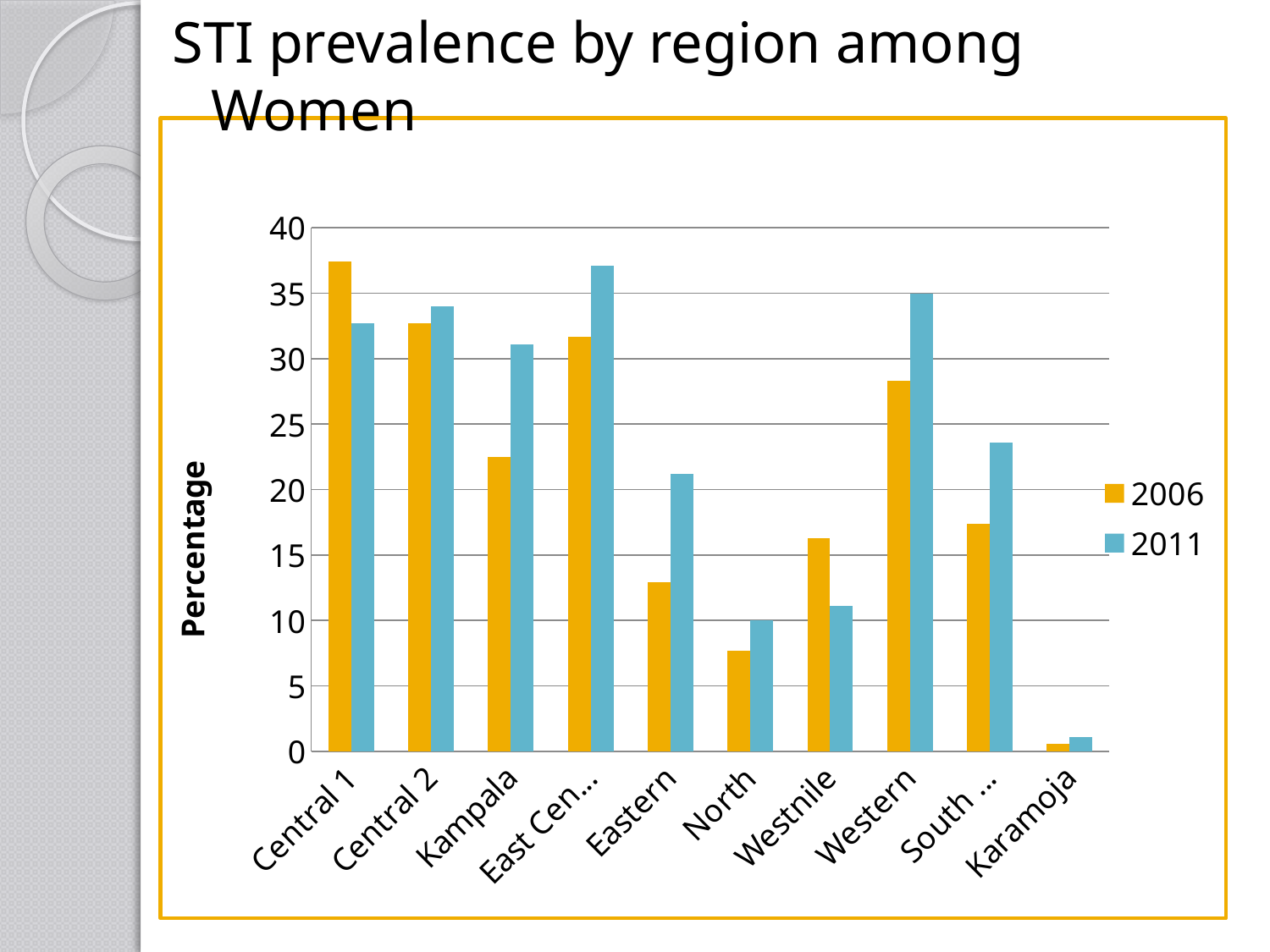
Is the 2011 value for Western greater or less than 30? greater What kind of chart is shown on the slide? bar chart For Westnile, which year has the larger value, 2006 or 2011? 2006 Which region has the lowest 2006 value? Karamoja How many regions are shown on the x axis? 10 How many series does the legend list? 2 Is the 2006 value for North greater or less than 10? less What is the label of the vertical axis? Percentage Which region has the highest 2006 value? Central 1 Is the 2006 value for Kampala greater or less than 25? less Which region has the lowest 2011 value? Karamoja For Kampala, which year has the larger value, 2006 or 2011? 2011